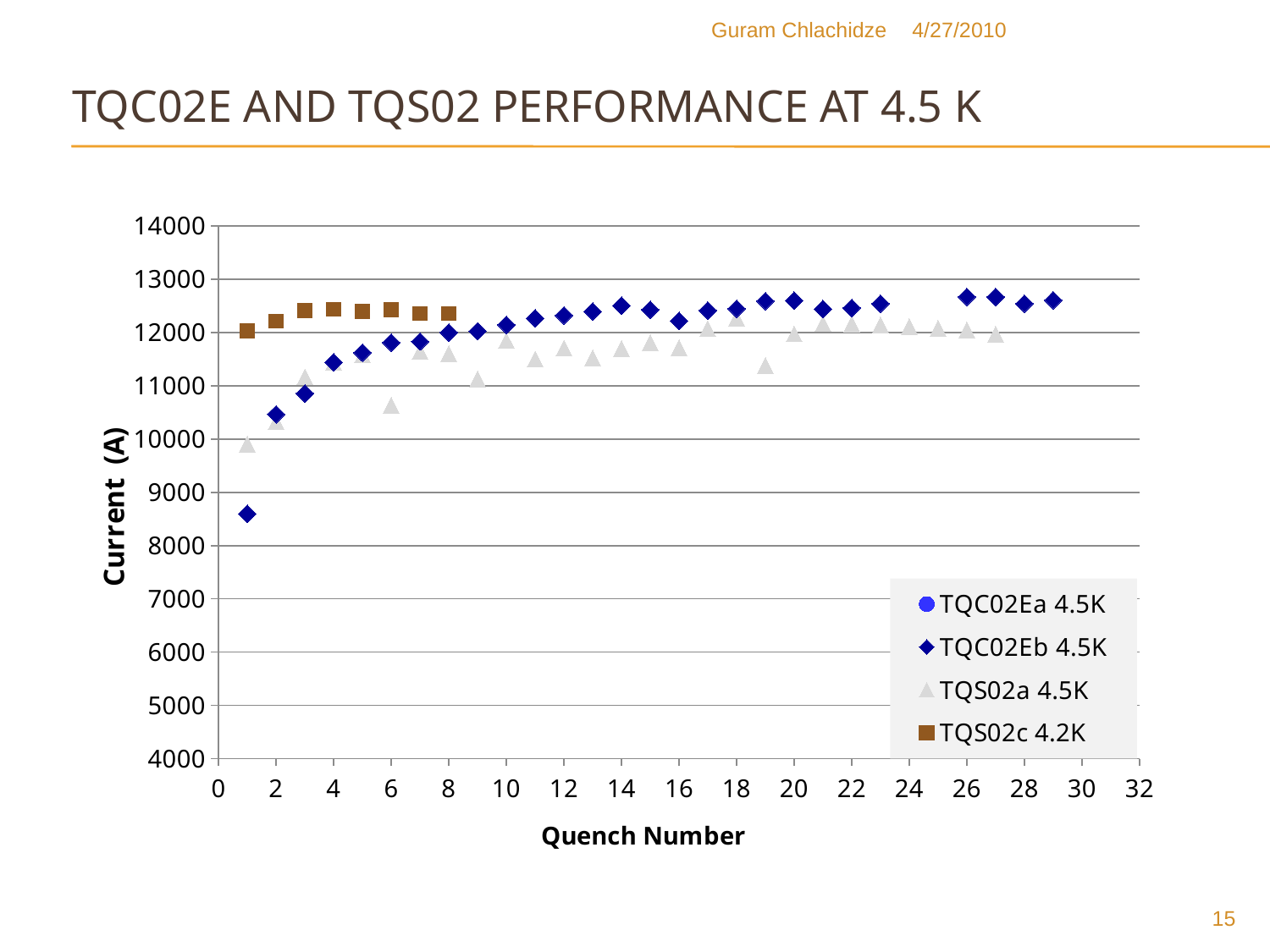
Is the value for TQC02Eb 4.5K at quench number 26 greater or less than 13000? less What kind of chart is shown on the slide? scatter chart Is the value for TQC02Eb 4.5K at quench number 1 greater or less than 9000? less How many series does the legend list? 4 Is the value for TQS02a 4.5K at quench number 6 greater or less than 11000? less Do the values for TQC02Eb 4.5K generally rise or fall as the quench number increases? rise At quench number 1, which series has the larger value, TQC02Eb 4.5K or TQS02a 4.5K? TQS02a 4.5K What is the label of the y axis? Current (A) At quench number 3, which series has the larger value, TQS02c 4.2K or TQC02Eb 4.5K? TQS02c 4.2K What is the label of the x axis? Quench Number